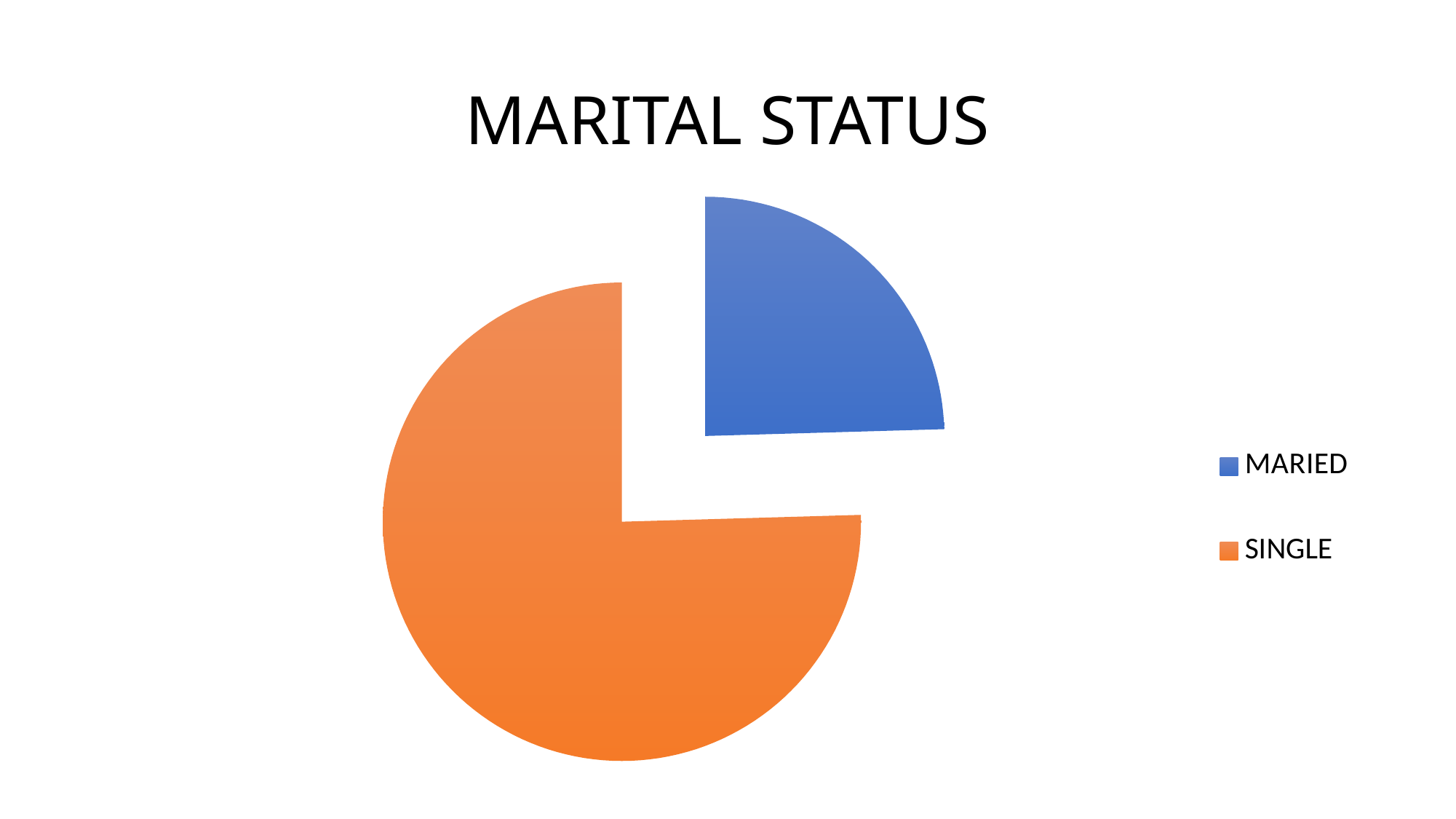
Which category has the largest slice of the pie? SINGLE How many categories does the legend list? 2 Which slice is larger, MARIED or SINGLE? SINGLE Which category has the smallest slice of the pie? MARIED What kind of chart is shown on the slide? pie chart What colour is the SINGLE slice? orange What is the title of the chart? MARITAL STATUS Which category is shown in blue? MARIED